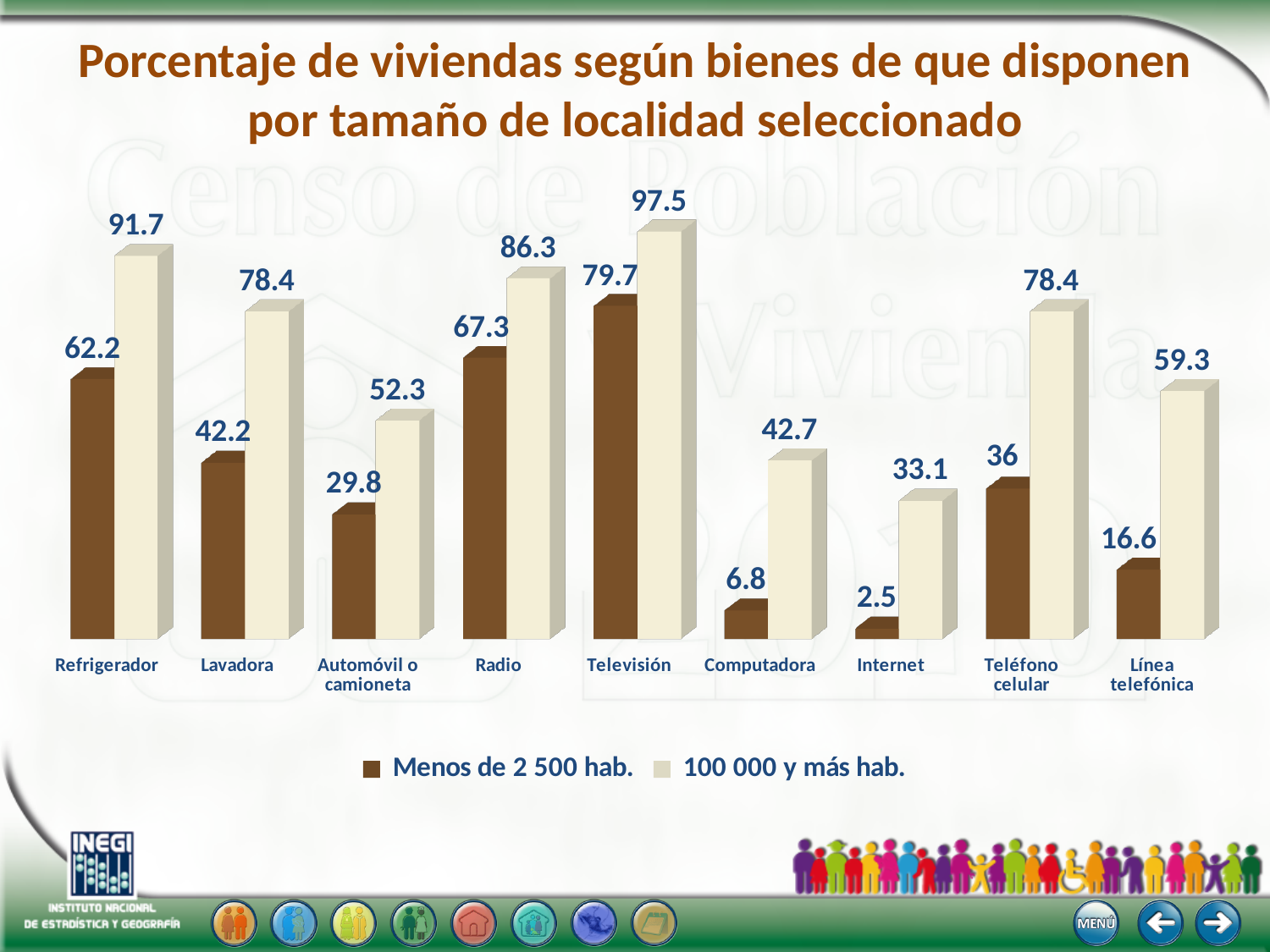
How many categories are shown on the x axis? 9 What is the difference between the two series for Refrigerador? 29.5 What is the value for Internet in the 'Menos de 2 500 hab.' series? 2.5 How many series does the legend list? 2 Which is larger: the 'Menos de 2 500 hab.' value for Radio or for Lavadora? Radio Which category has the lowest value in the '100 000 y más hab.' series? Internet What is the value for Teléfono celular in the 'Menos de 2 500 hab.' series? 36 What kind of chart is shown on the slide? Bar chart What is the difference between the '100 000 y más hab.' and 'Menos de 2 500 hab.' values for Computadora? 35.9 Which series is shown in brown? Menos de 2 500 hab. Which category has the highest value in the 'Menos de 2 500 hab.' series? Televisión What is the value for Televisión in the '100 000 y más hab.' series? 97.5